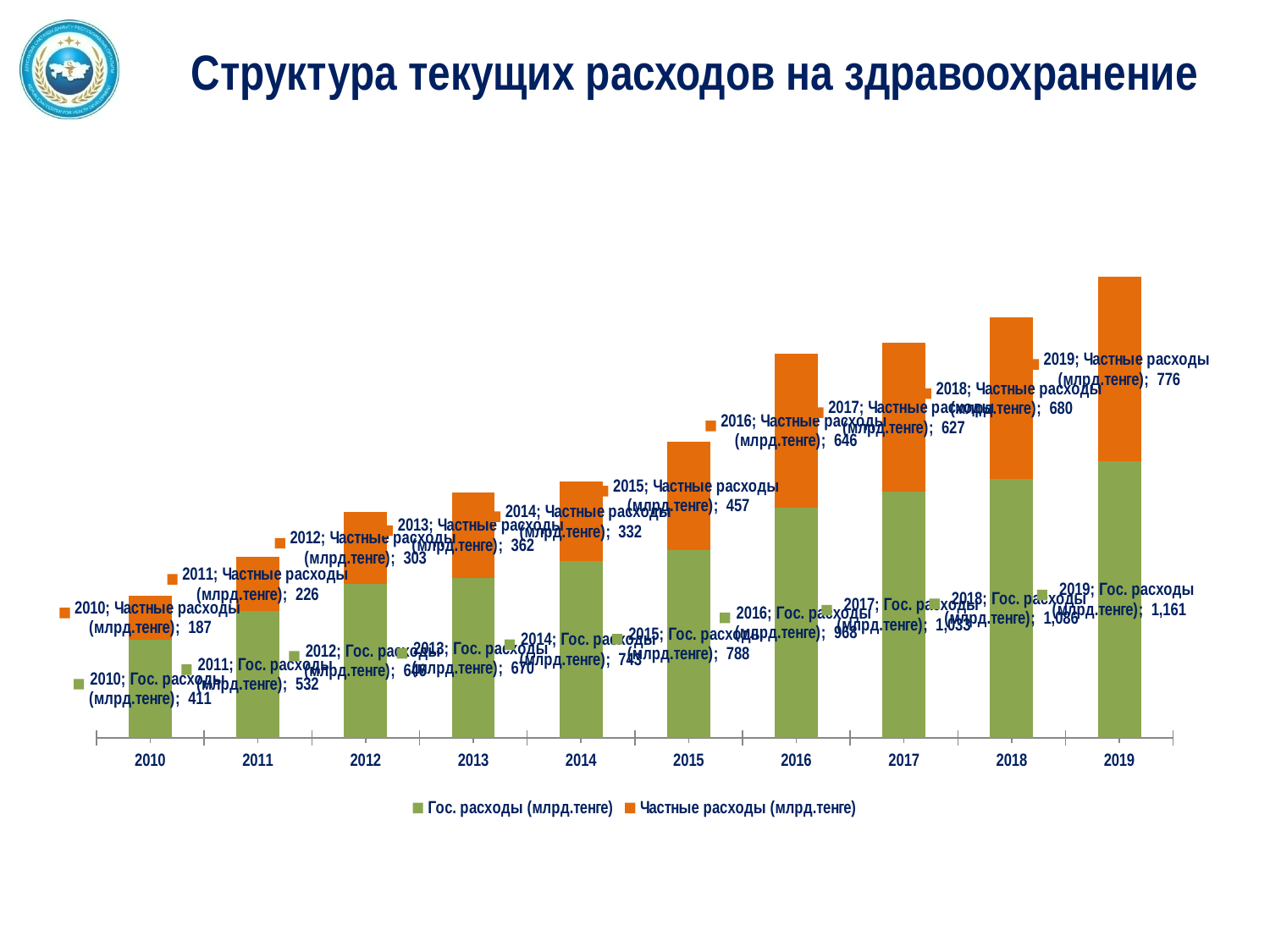
How many series does the legend list? 2 How many years are shown on the x axis? 10 Do Гос. расходы (млрд.тенге) rise or fall from 2010 to 2019? Rise What is the value of Частные расходы (млрд.тенге) for 2019? 776 In which year are Гос. расходы (млрд.тенге) the lowest? 2010 What is the total of the stacked bar for 2010? 598 Which year has the larger value for Частные расходы (млрд.тенге), 2013 or 2014? 2013 What kind of chart is shown on the slide? Stacked bar chart What is the value of Гос. расходы (млрд.тенге) for 2016? 968 In which year are Частные расходы (млрд.тенге) the highest? 2019 What is the value of Гос. расходы (млрд.тенге) for 2010? 411 By how much did Частные расходы (млрд.тенге) increase from 2010 to 2019? 589